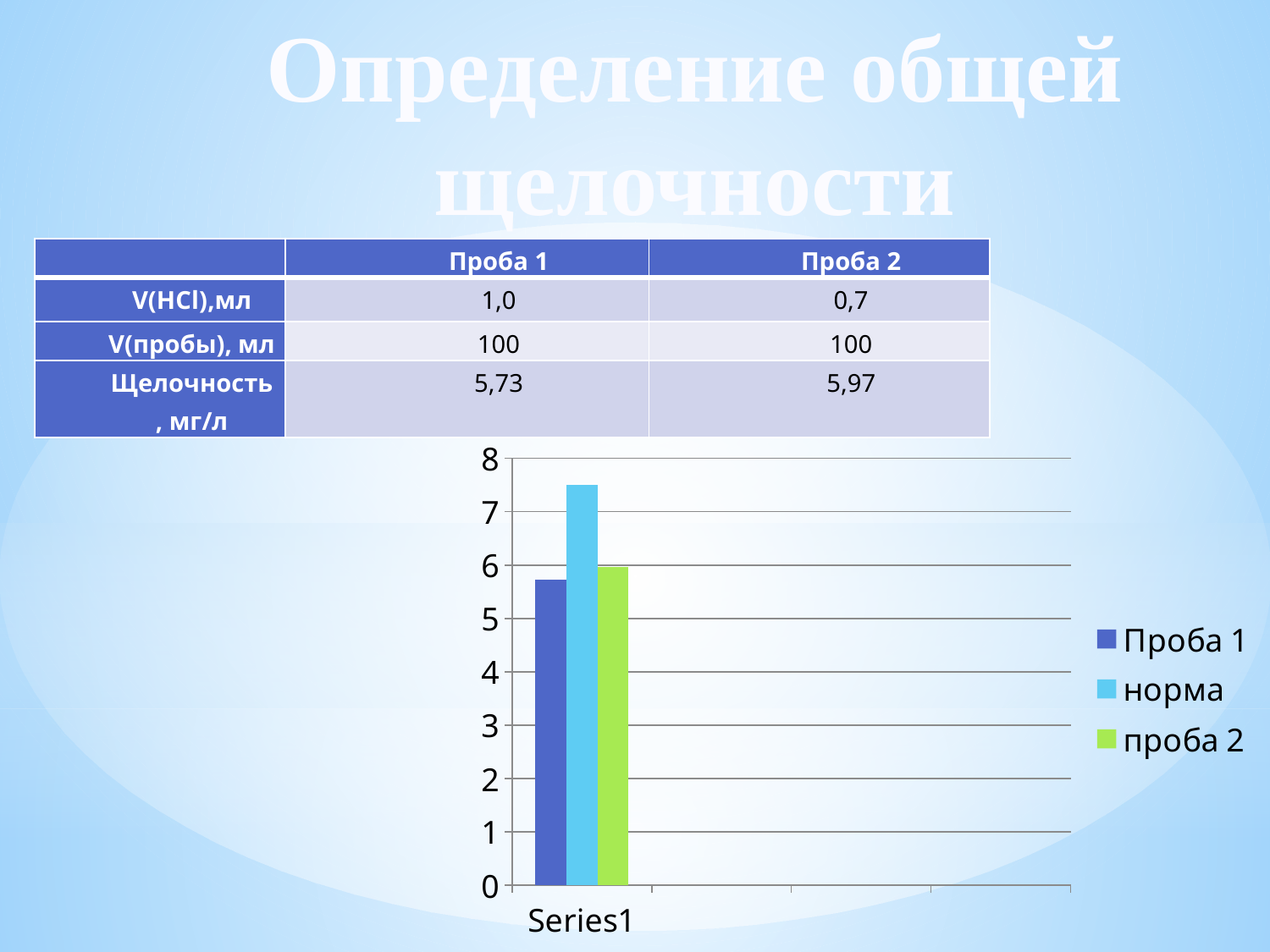
Which series has the tallest bar in the chart? норма Is the value for проба 2 in the chart greater or less than 7? less Is the value for Проба 1 in the chart greater or less than 6? less Is the value for Проба 1 in the chart greater or less than 5? greater What kind of chart is shown on the slide? bar chart Which bar is taller in the chart, норма or проба 2? норма What are the three entries listed in the chart legend? Проба 1, норма, проба 2 How many categories are shown on the x axis of the chart? 1 How many series does the chart legend list? 3 Which bar is taller in the chart, норма or Проба 1? норма What is the category label shown on the x axis of the chart? Series1